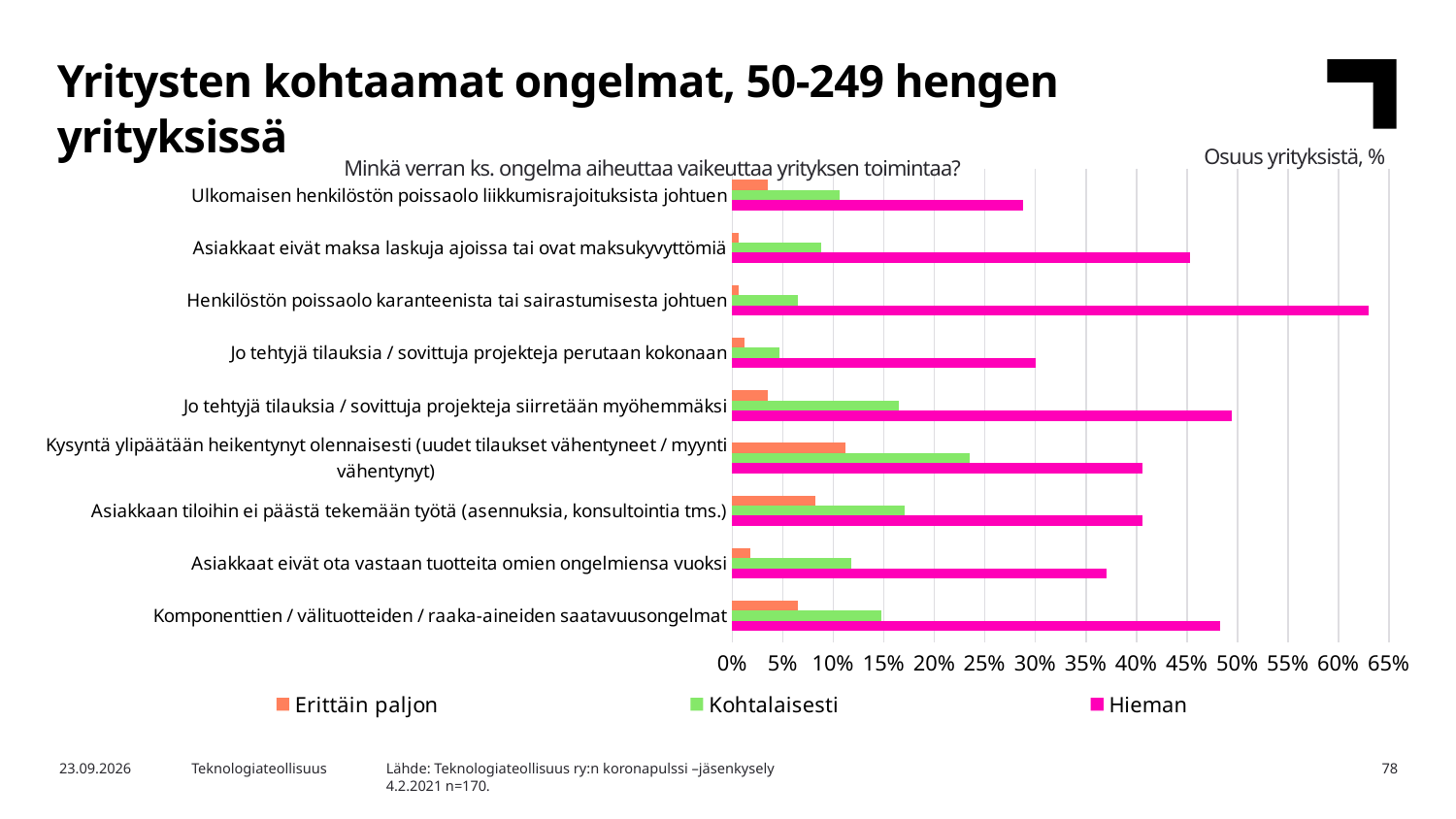
Which category has the highest value for the 'Erittäin paljon' series? Kysyntä ylipäätään heikentynyt olennaisesti (uudet tilaukset vähentyneet / myynti vähentynyt) How many problem categories are plotted on the chart? 9 Which category has the highest value for the 'Hieman' series? Henkilöstön poissaolo karanteenista tai sairastumisesta johtuen For the 'Hieman' series, which is larger: 'Ulkomaisen henkilöstön poissaolo liikkumisrajoituksista johtuen' or 'Asiakkaat eivät ota vastaan tuotteita omien ongelmiensa vuoksi'? Asiakkaat eivät ota vastaan tuotteita omien ongelmiensa vuoksi Is the 'Hieman' value for 'Henkilöstön poissaolo karanteenista tai sairastumisesta johtuen' greater or less than 60%? greater What colour represents the 'Hieman' series in the chart? Magenta (pink) Is the 'Kohtalaisesti' value for 'Kysyntä ylipäätään heikentynyt olennaisesti' greater or less than 20%? greater Is the 'Hieman' value for 'Asiakkaat eivät maksa laskuja ajoissa tai ovat maksukyvyttömiä' greater or less than 40%? greater Which category has the highest value for the 'Kohtalaisesti' series? Kysyntä ylipäätään heikentynyt olennaisesti (uudet tilaukset vähentyneet / myynti vähentynyt) What kind of chart is shown on the slide? Bar chart How many series does the legend list? 3